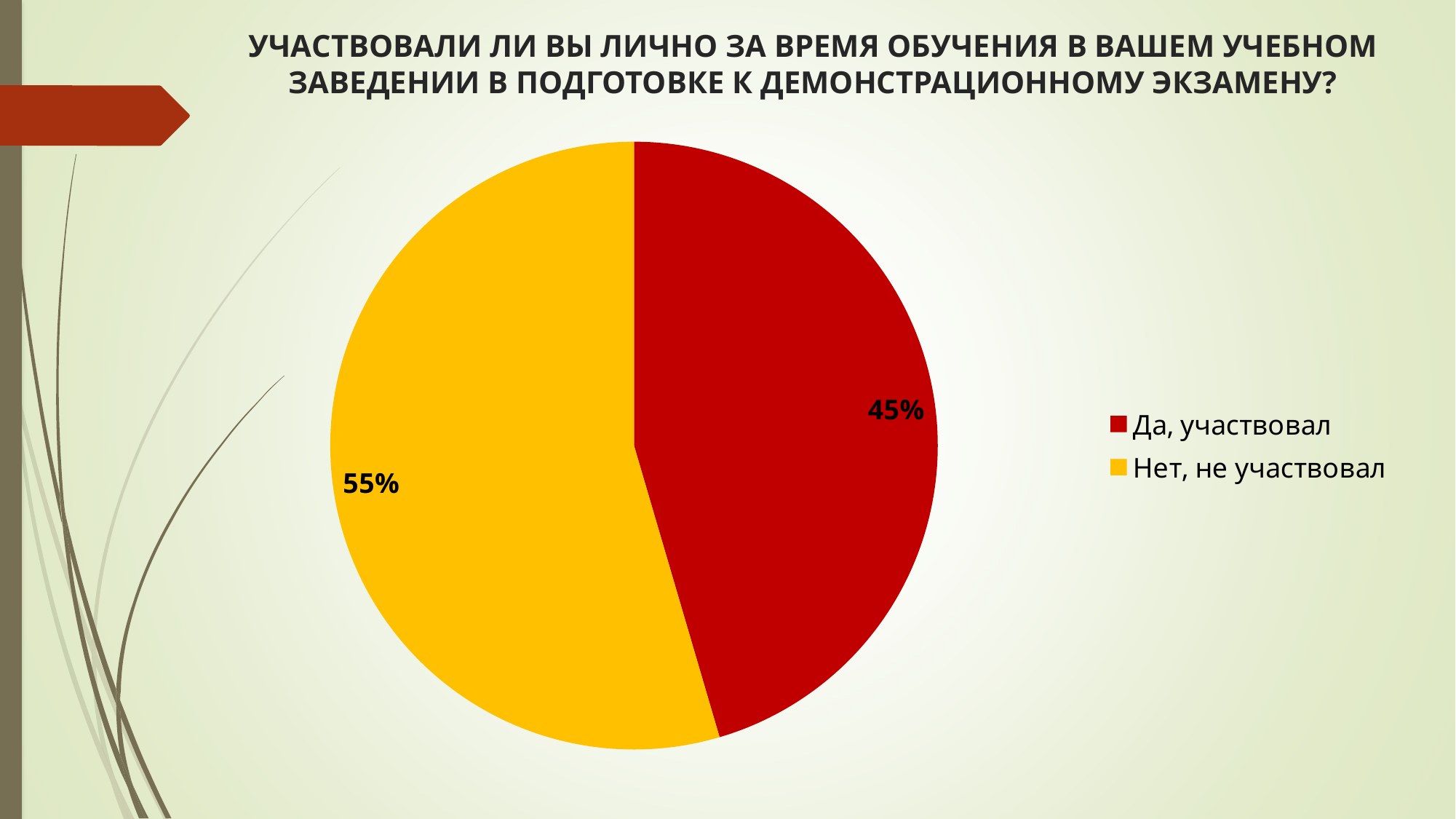
How many slices does the pie chart have? 2 Which is larger: the share for "Да, участвовал" or for "Нет, не участвовал"? Нет, не участвовал Which answer has the smallest share of the pie? Да, участвовал What is the difference in percentage points between "Нет, не участвовал" and "Да, участвовал"? 10% How many entries does the legend list? 2 What share of respondents answered "Нет, не участвовал"? 55% What colour is the slice for "Нет, не участвовал"? Yellow What kind of chart is shown on the slide? Pie chart Which answer has the largest share of the pie? Нет, не участвовал What colour is the slice for "Да, участвовал"? Red What share of respondents answered "Да, участвовал"? 45% Is the share for "Да, участвовал" greater or less than 50%? less